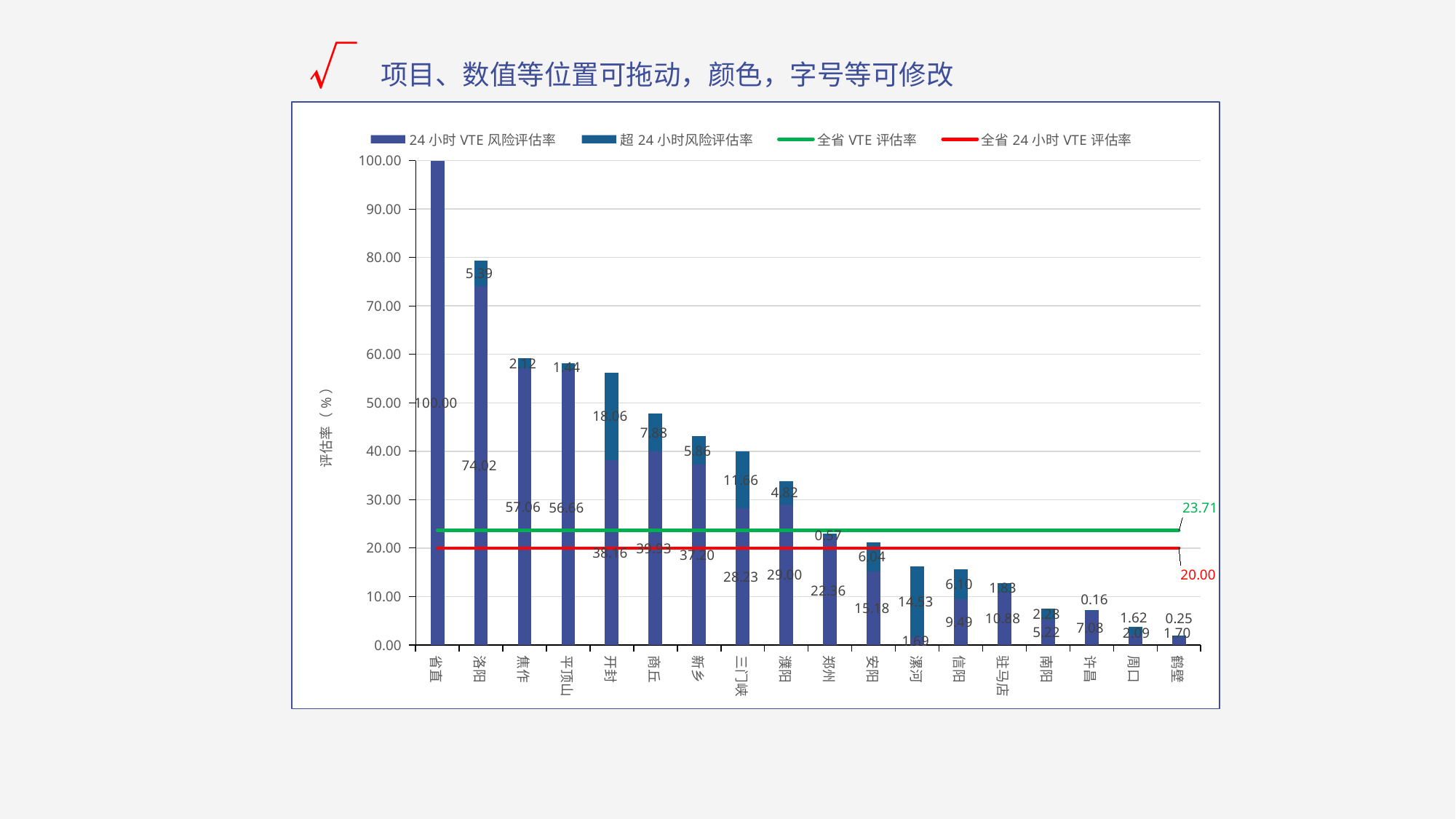
What is the difference between the 24 小时 VTE 风险评估率 values of 焦作 (57.06) and 平顶山 (56.66)? 0.40 What is the 24 小时 VTE 风险评估率 value for 洛阳? 74.02 What is the 超 24 小时风险评估率 value for 开封? 18.06 How many categories are shown on the x axis? 18 Which category has the highest 24 小时 VTE 风险评估率? 省直 Do the bar heights generally rise or fall from left to right along the x axis? Fall Which has the larger 24 小时 VTE 风险评估率, 洛阳 or 焦作? 洛阳 How many series does the legend list? 4 What is the 24 小时 VTE 风险评估率 value for 省直? 100.00 What value is labelled on the red 全省 24 小时 VTE 评估率 line? 20.00 What value is labelled on the green 全省 VTE 评估率 line? 23.71 What kind of chart is this? Combination stacked bar and line chart